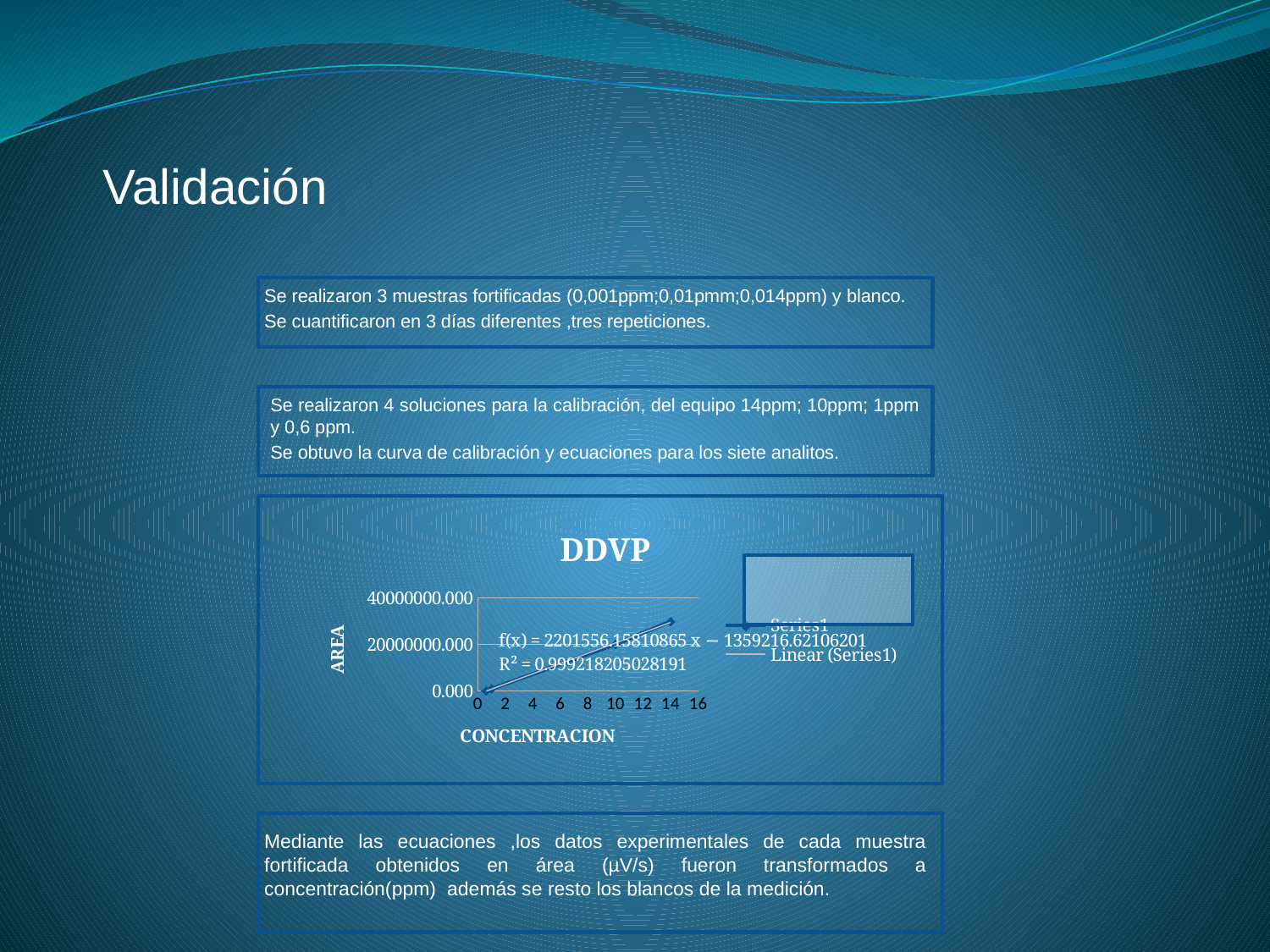
What is the trendline equation shown on the DDVP chart? f(x) = 2201556.15810865 x − 1359216.62106201 What is the highest tick value shown on the y axis of the DDVP chart? 40000000.000 What is the title of the chart on the slide? DDVP What is the R² value shown on the DDVP chart? 0.999218205028191 What is the highest tick value shown on the x axis of the DDVP chart? 16 In the DDVP chart, is the area value at concentration 14 greater or less than 20000000.000? greater What is the slope of the trendline in the DDVP chart? 2201556.15810865 Do the values in the DDVP chart rise or fall as concentration increases along the x axis? rise What kind of chart is the DDVP chart? scatter chart What is the label of the x axis of the DDVP chart? CONCENTRACION What is the label of the y axis of the DDVP chart? AREA How many entries does the legend of the DDVP chart list? 2